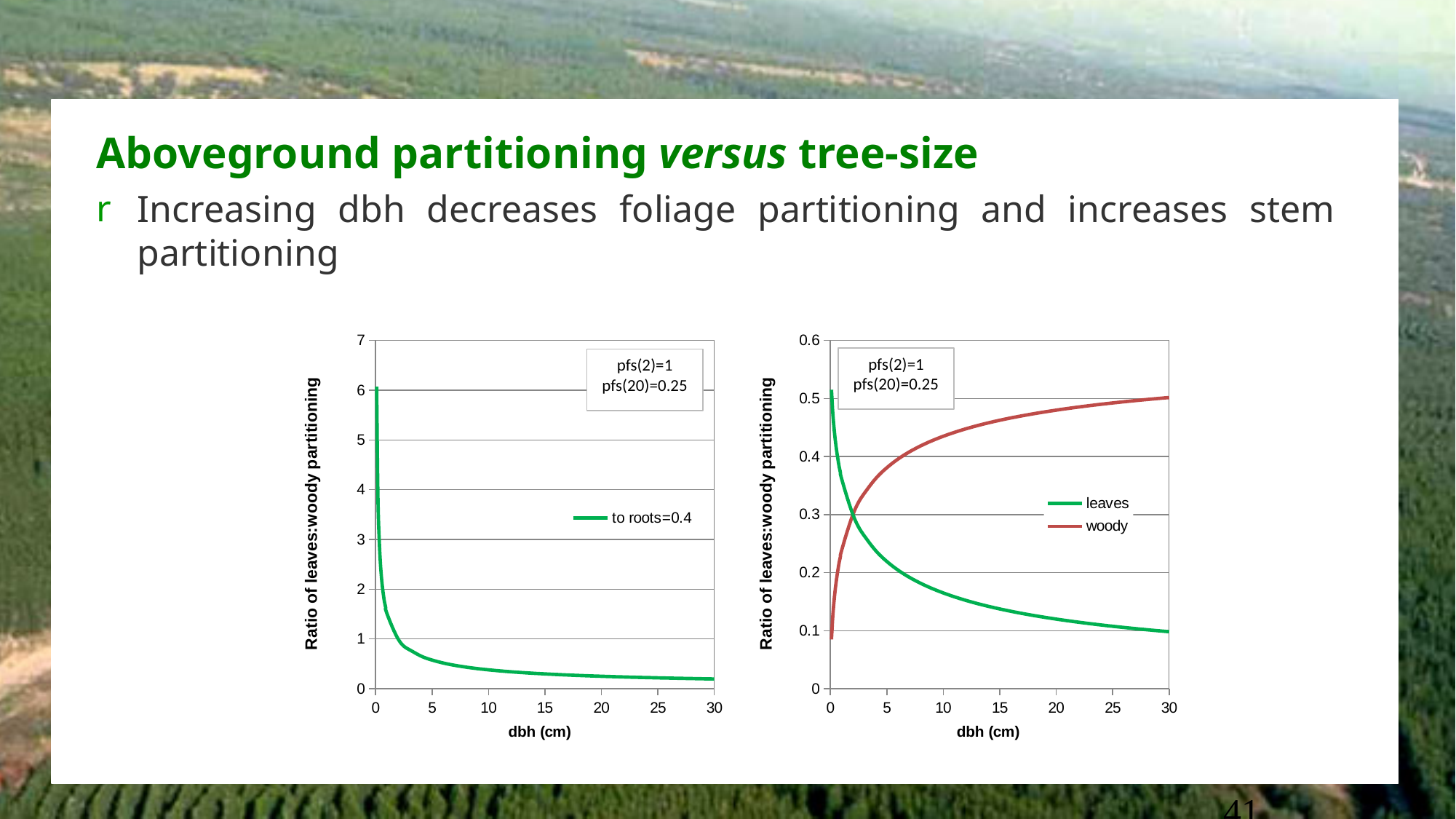
In the right chart, is the value of the woody series at dbh 30 cm greater or less than 0.4? greater In the left chart, is the value of the to roots=0.4 series at dbh 30 cm greater or less than 1? less What is the x-axis label of the right chart? dbh (cm) What type of chart is the left chart? line chart In the right chart, is the value of the leaves series at dbh 30 cm greater or less than 0.2? less What is the name of the series in the legend of the left chart? to roots=0.4 In the right chart, at dbh 20 cm, which series has the larger value, leaves or woody? woody In the right chart, does the woody series rise or fall as dbh increases? rise In the left chart, does the ratio of leaves:woody partitioning rise or fall as dbh increases? fall What are the two series named in the legend of the right chart? leaves and woody How many series does the legend of the right chart list? 2 In the right chart, does the leaves series rise or fall as dbh increases? fall